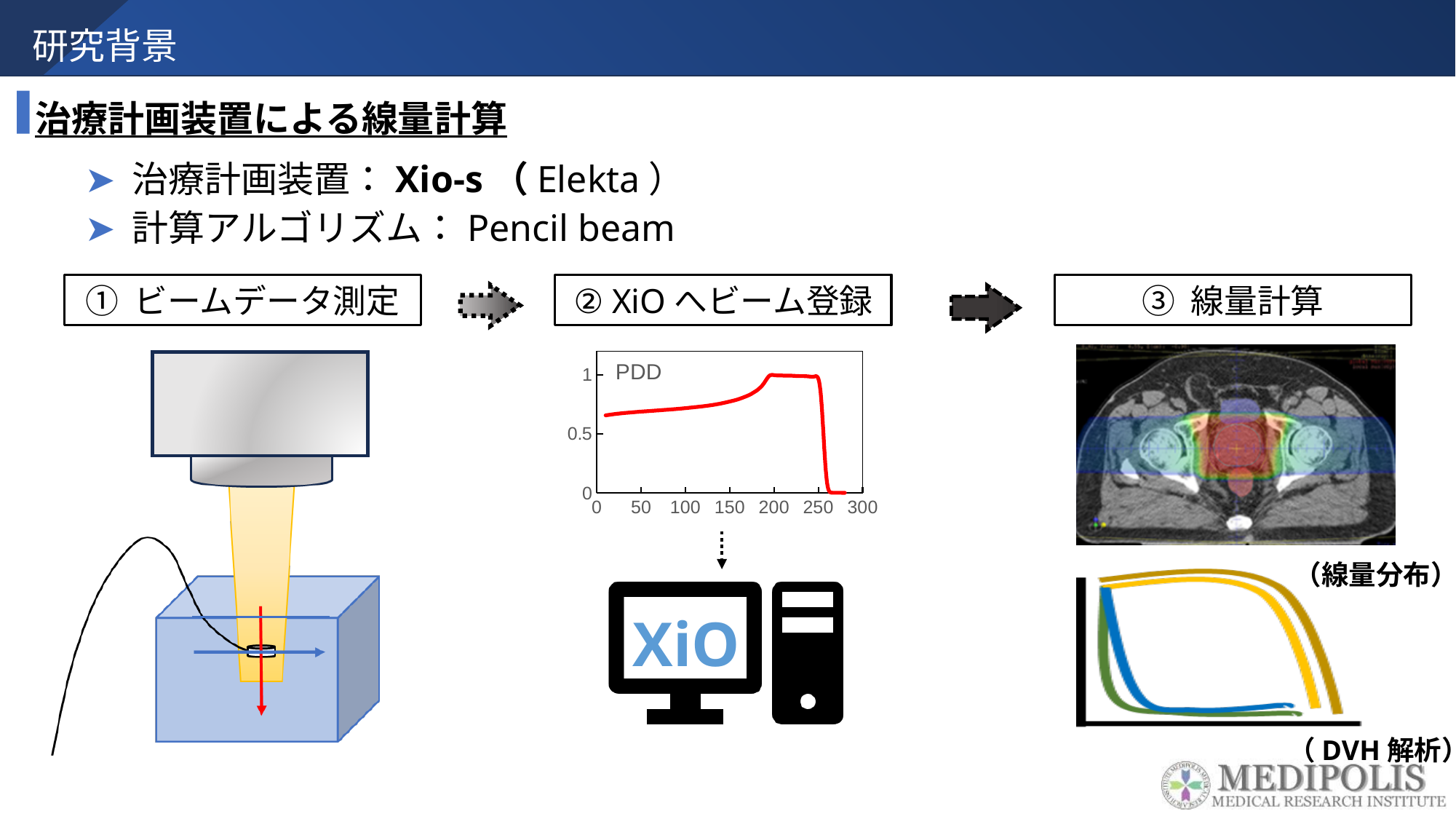
What kind of chart is the PDD chart in the middle of the slide? line chart On the PDD chart, is the value of the red line higher at x = 200 or at x = 50? x = 200 On the PDD chart, does the red line rise or fall between x = 250 and x = 270? fall What label is written inside the plot area of the line chart in the middle of the slide? PDD On the PDD chart, is the value of the red line at x = 100 greater or less than 0.5? greater On the PDD chart, is the value of the red line higher at x = 150 or at x = 280? x = 150 How many lines are plotted on the PDD chart? 1 On the PDD chart, does the red line rise or fall between x = 0 and x = 200? rise On the PDD chart, is the value of the red line at x = 280 greater or less than 0.5? less On the PDD chart, what is the highest tick value shown on the x axis? 300